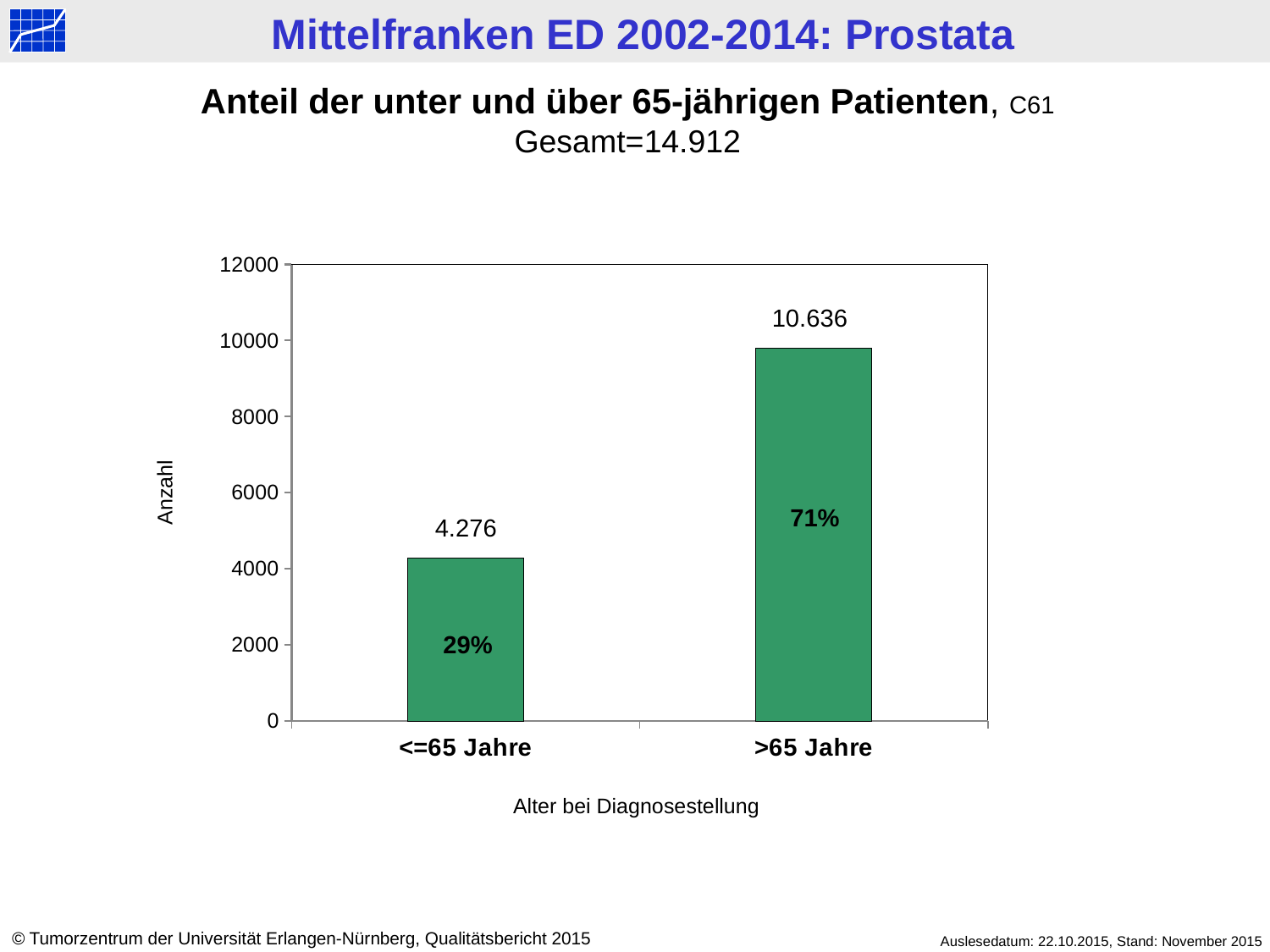
What percentage is shown inside the <=65 Jahre bar? 29% What is the value for the <=65 Jahre category? 4.276 Is the value for <=65 Jahre greater or less than 6000? less Which is larger, the value for <=65 Jahre or the value for >65 Jahre? >65 Jahre How many categories are shown on the x axis? 2 Which category has the highest value? >65 Jahre What is the difference between the values for >65 Jahre and <=65 Jahre? 6.360 What kind of chart is shown on the slide? bar chart Which category has the lowest value? <=65 Jahre What is the value for the >65 Jahre category? 10.636 What is the label of the y axis? Anzahl What percentage is shown inside the >65 Jahre bar? 71%